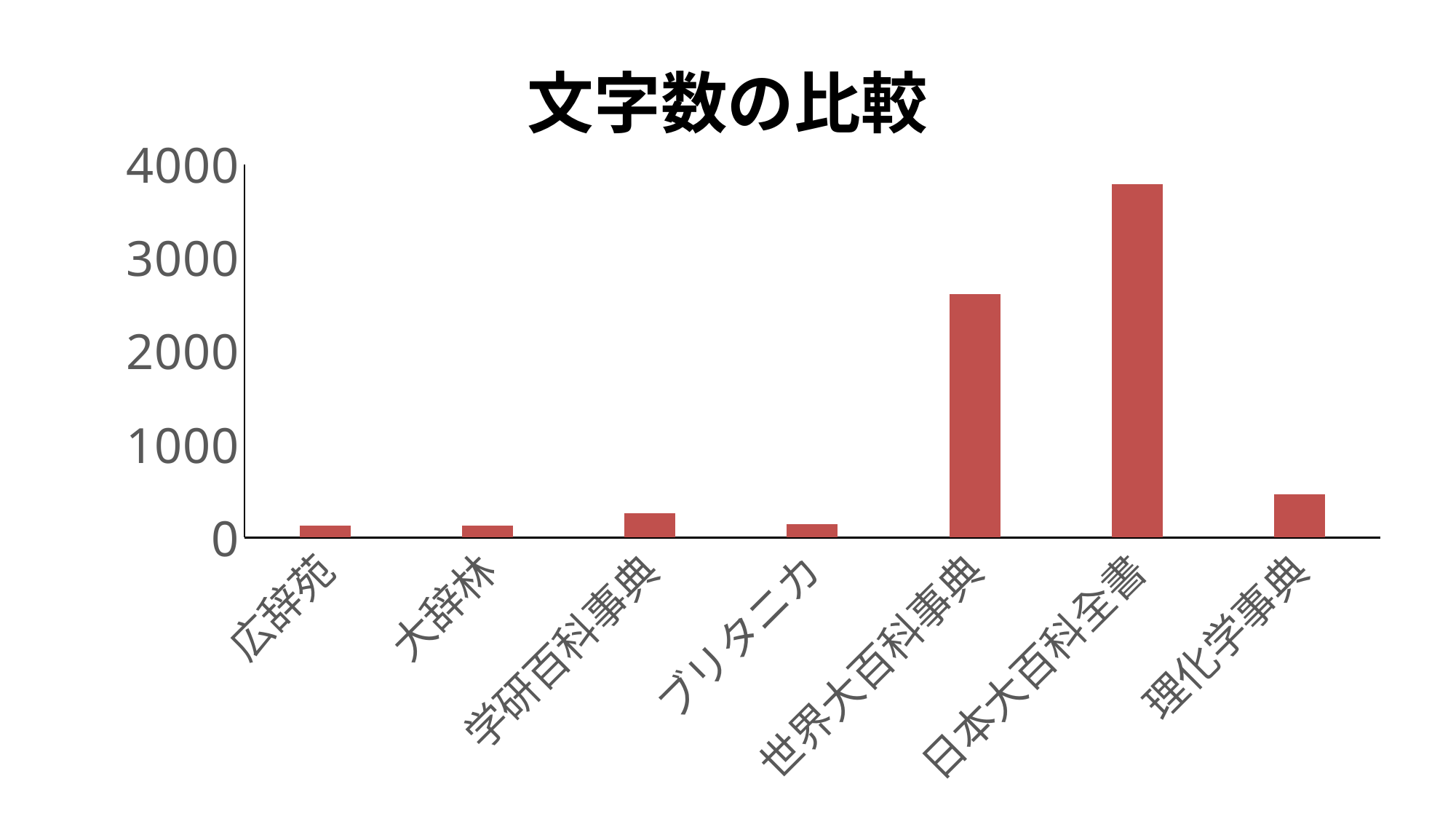
Which is larger, the value for 理化学事典 or the value for 広辞苑? 理化学事典 Is the value for 世界大百科事典 greater or less than 2000? greater Is the value for 学研百科事典 greater or less than 1000? less What colour are the bars in the chart? red Which category has the highest value? 日本大百科全書 Is the value for 日本大百科全書 greater or less than 3000? greater What kind of chart is shown on the slide? bar chart What is the title of the chart? 文字数の比較 How many categories are shown on the x axis? 7 Which is larger, the value for 世界大百科事典 or the value for 日本大百科全書? 日本大百科全書